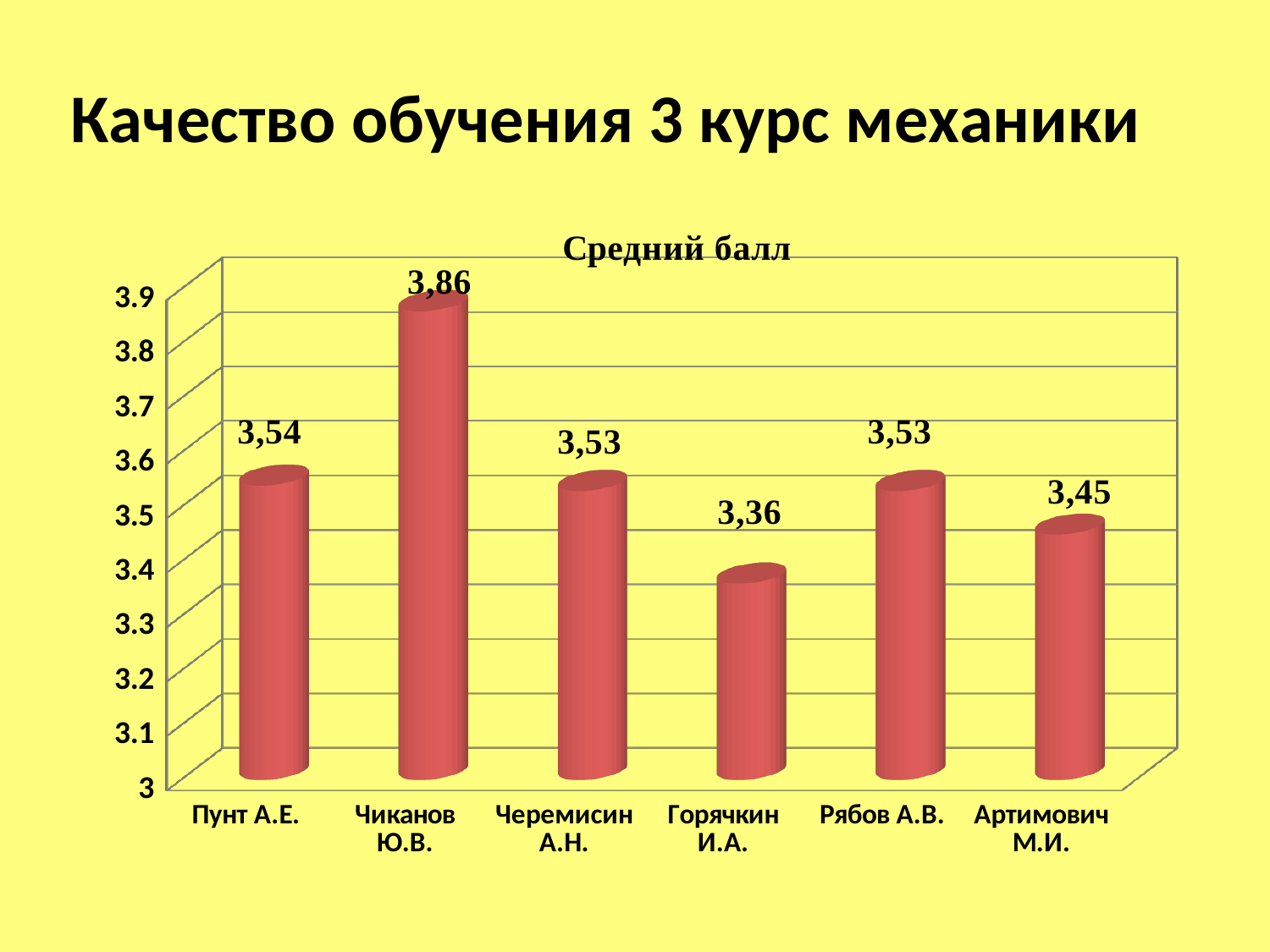
What is the value for Чиканов Ю.В.? 3,86 What is the title of the chart? Средний балл What is the difference between the values for Чиканов Ю.В. and Горячкин И.А.? 0,50 Is the value for Чиканов Ю.В. greater or less than 3.8? greater What is the value for Артимович М.И.? 3,45 What is the value for Пунт А.Е.? 3,54 Which is larger, the value for Пунт А.Е. or the value for Артимович М.И.? Пунт А.Е. Which category has the highest value? Чиканов Ю.В. What is the value for Горячкин И.А.? 3,36 What kind of chart is shown on the slide? bar chart How many categories are shown on the chart? 6 Which category has the lowest value? Горячкин И.А.